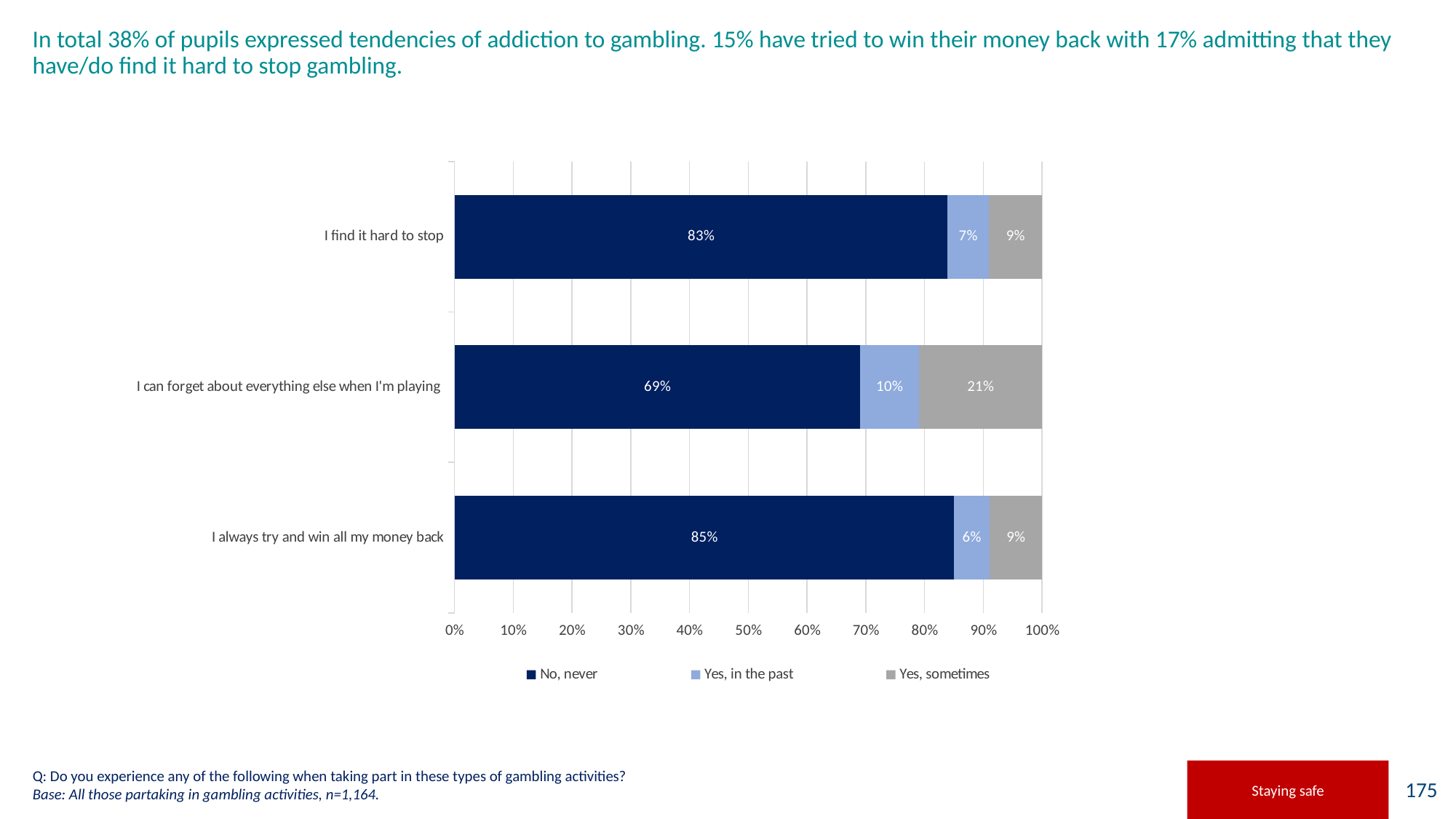
What percentage of pupils answered 'Yes, sometimes' for 'I can forget about everything else when I'm playing'? 21% What is the difference between the 'Yes, sometimes' percentages for 'I can forget about everything else when I'm playing' and 'I find it hard to stop'? 12% Is the 'No, never' value for 'I can forget about everything else when I'm playing' greater or less than 70%? less Which is larger: the 'Yes, in the past' value for 'I can forget about everything else when I'm playing' or for 'I find it hard to stop'? I can forget about everything else when I'm playing How many series does the legend list? 3 What is the combined percentage of 'Yes, in the past' and 'Yes, sometimes' for 'I find it hard to stop'? 16% Which statement has the lowest 'No, never' percentage? I can forget about everything else when I'm playing What kind of chart is shown on the slide? Stacked bar chart Which statement has the highest 'No, never' percentage? I always try and win all my money back How many statements are shown on the chart? 3 What percentage of pupils answered 'Yes, in the past' for 'I always try and win all my money back'? 6% What percentage of pupils answered 'No, never' for 'I find it hard to stop'? 83%